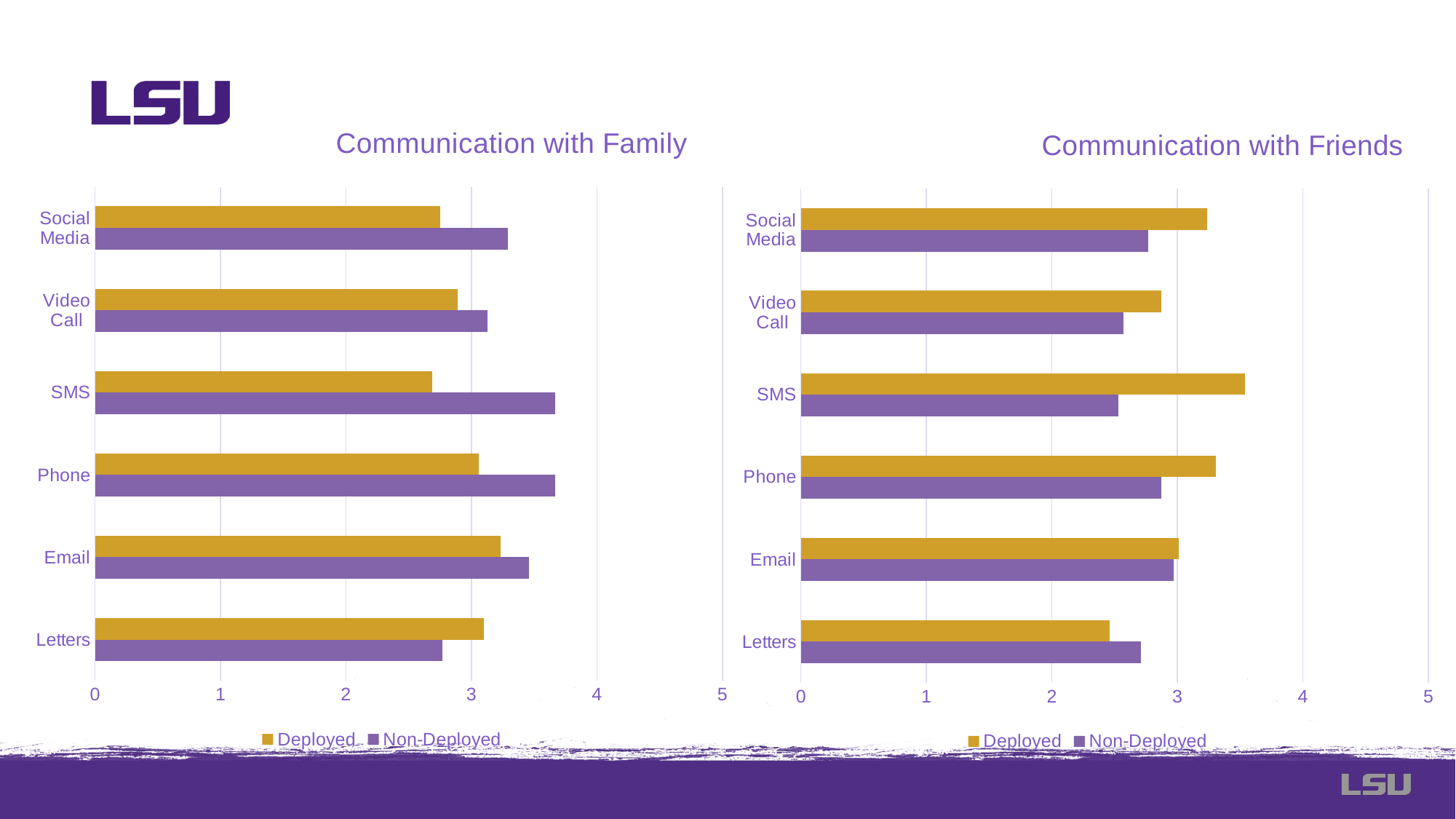
What kind of chart is the "Communication with Family" chart? bar chart On the "Communication with Friends" chart, which is larger for SMS: Deployed or Non-Deployed? Deployed How many series does the legend of the "Communication with Family" chart list? 2 On the "Communication with Friends" chart, which category has the highest Deployed value? SMS On the "Communication with Friends" chart, is the Deployed value for Letters greater or less than 3? less On the "Communication with Family" chart, which is larger for Letters: Deployed or Non-Deployed? Deployed On the "Communication with Family" chart, is the Deployed value for Social Media greater or less than 3? less On the "Communication with Friends" chart, which category has the lowest Deployed value? Letters On the "Communication with Family" chart, is the Non-Deployed value for SMS greater or less than 3? greater How many communication categories are shown on the "Communication with Friends" chart? 6